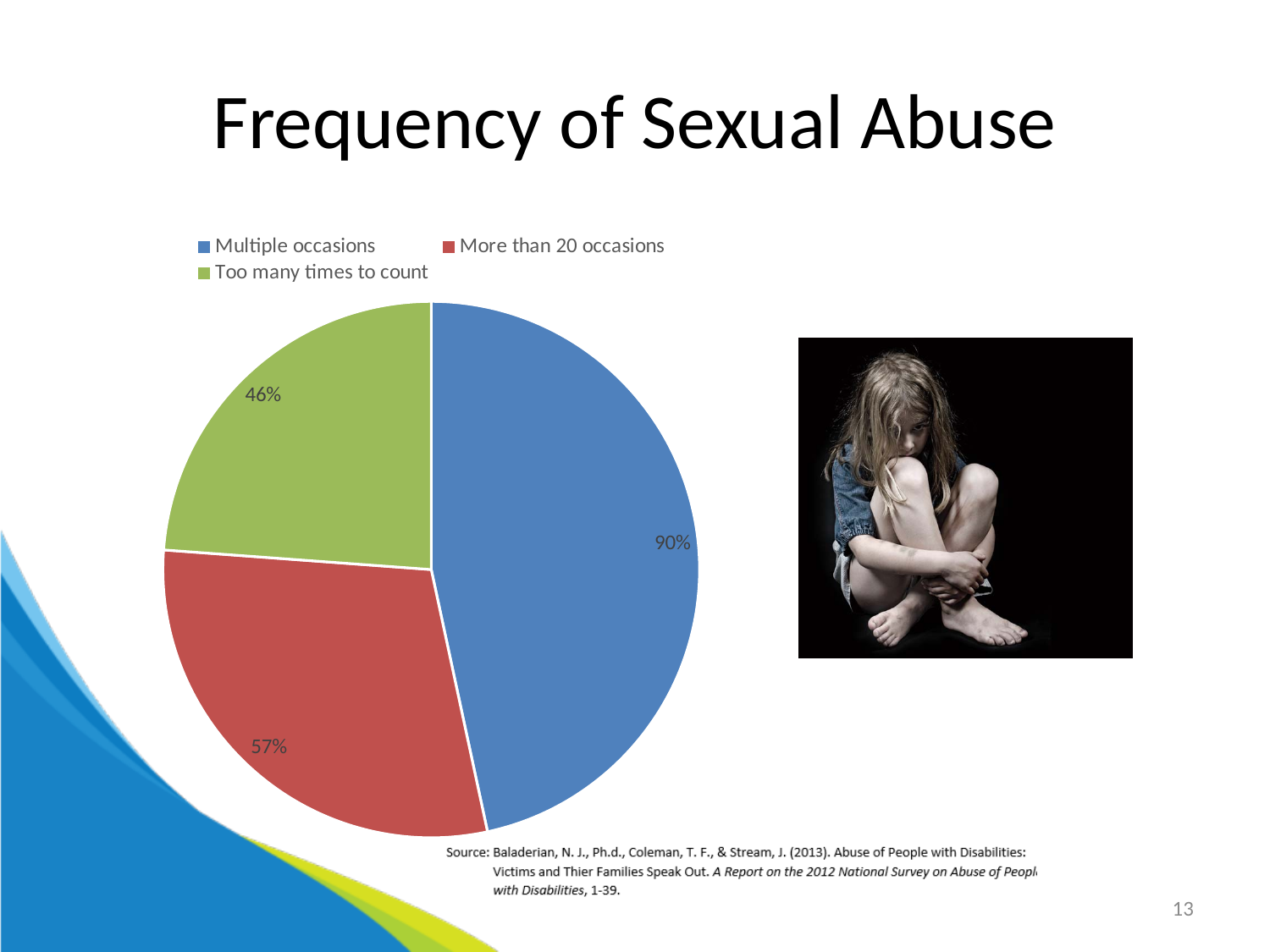
What value is labelled on the slice for More than 20 occasions? 57% How many categories does the legend of the pie chart list? 3 Which category has the smallest slice in the pie chart? Too many times to count What is the difference between the labelled values for Multiple occasions and More than 20 occasions? 33% What colour is the slice for Too many times to count? Green Which is larger, the value for More than 20 occasions or the value for Too many times to count? More than 20 occasions Which category has the largest slice in the pie chart? Multiple occasions What value is labelled on the slice for Too many times to count? 46% What type of chart is shown on the slide? Pie chart What value is labelled on the slice for Multiple occasions? 90% How many slices does the pie chart have? 3 What is the title of the slide containing the chart? Frequency of Sexual Abuse